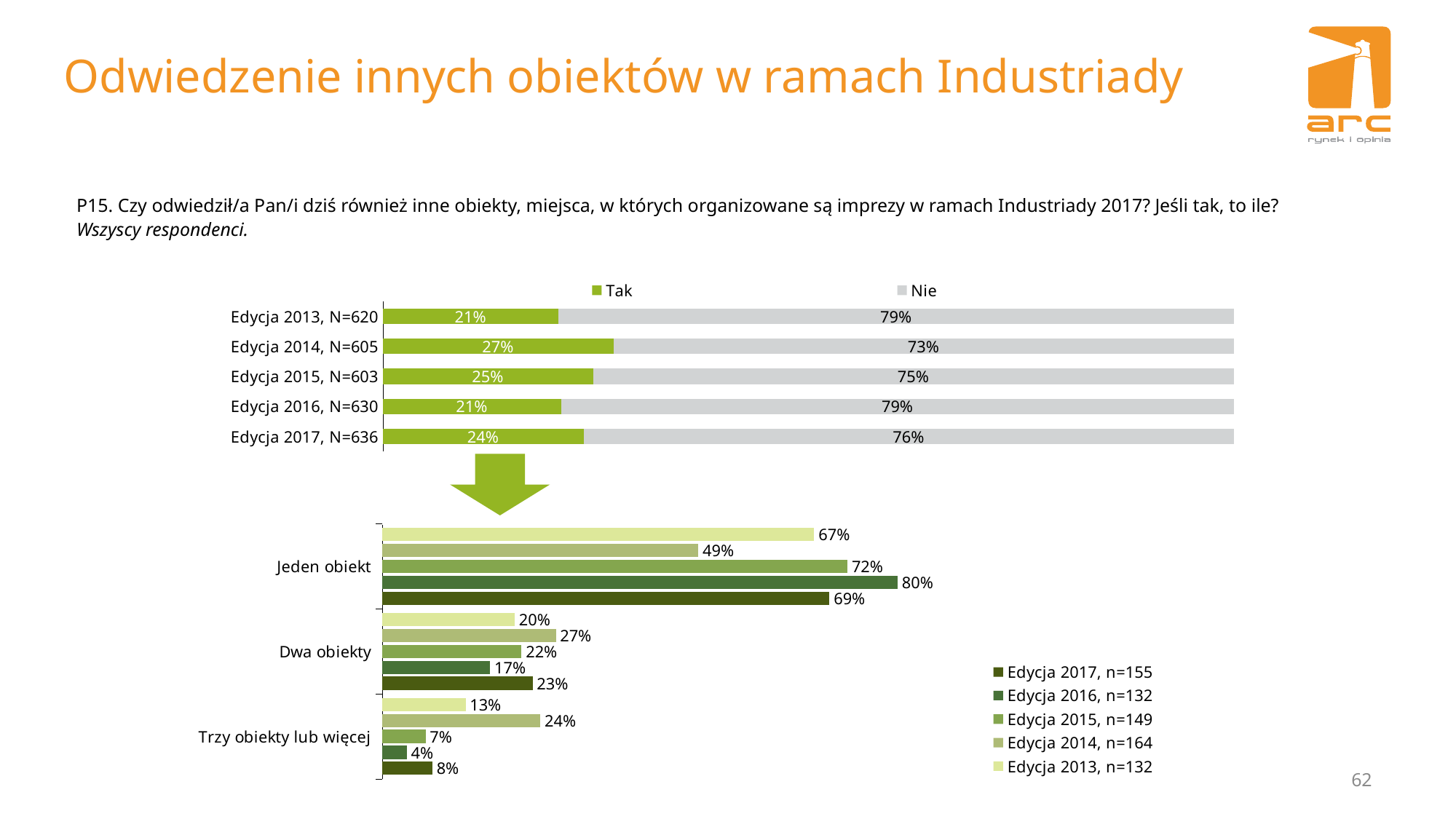
In the top chart, what is the 'Nie' value for Edycja 2017, N=636? 76% In the bottom chart, what is the value for 'Trzy obiekty lub więcej' in Edycja 2014, n=164? 24% In the top chart, what is the difference between the 'Tak' values for Edycja 2014, N=605 and Edycja 2013, N=620? 6% In the top chart, which edition has the highest 'Tak' share? Edycja 2014, N=605 In the top chart, what is the 'Tak' value for Edycja 2014, N=605? 27% In the top chart, what is the total of the 'Tak' and 'Nie' segments for Edycja 2015, N=603? 100% In the bottom chart, how many series does the legend list? 5 What kind of chart is the bottom chart? Bar chart In the bottom chart, which is larger for 'Dwa obiekty': Edycja 2014, n=164 or Edycja 2016, n=132? Edycja 2014, n=164 In the top chart, how many series does the legend list? 2 In the bottom chart, which edition has the lowest value for 'Trzy obiekty lub więcej'? Edycja 2016, n=132 In the bottom chart, what is the value for 'Jeden obiekt' in Edycja 2016, n=132? 80%